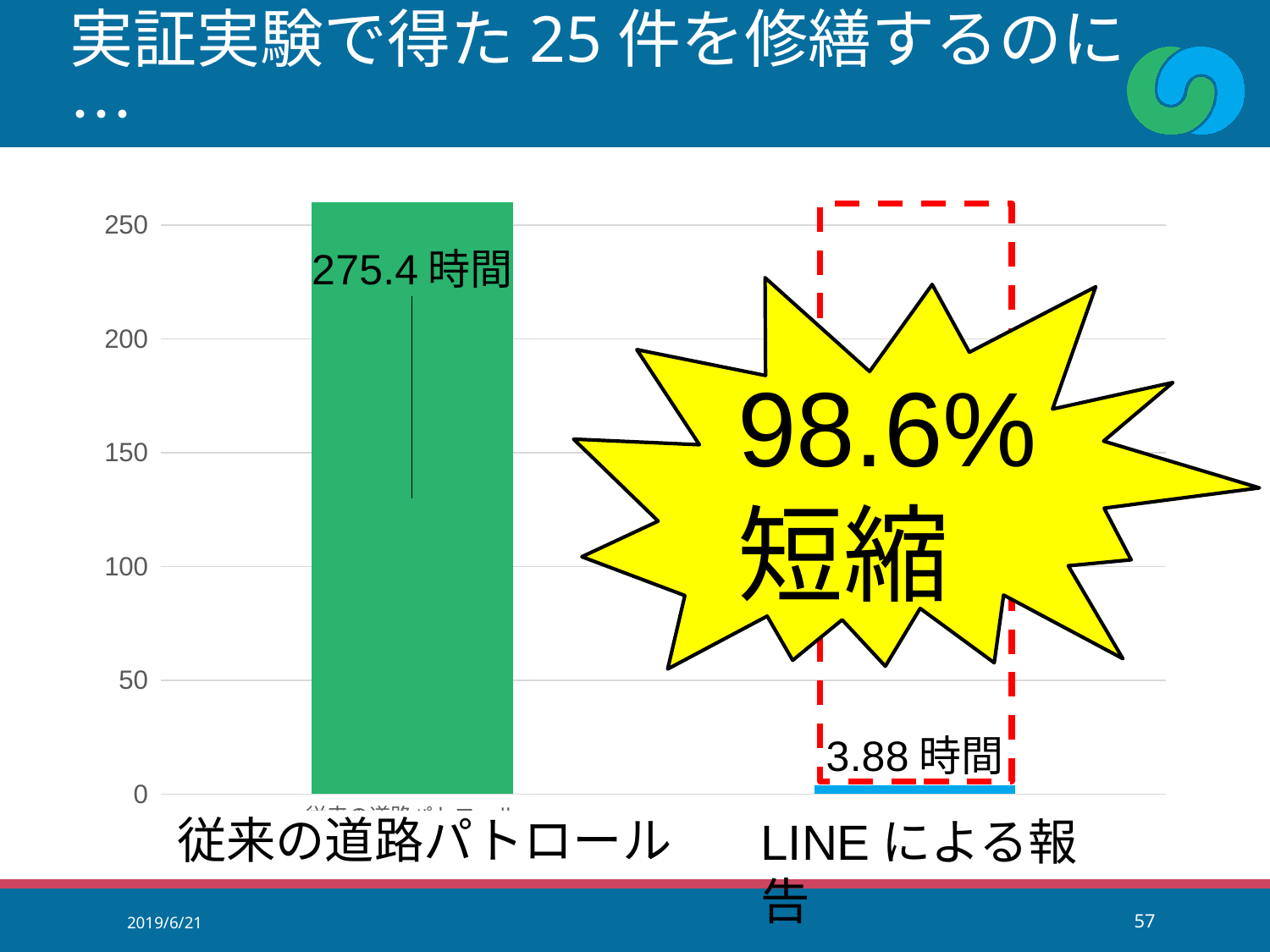
What percentage reduction is stated in the yellow starburst callout on the chart? 98.6% Is the value for LINE による報告 greater or less than 50? less Is the value for 従来の道路パトロール greater or less than 250? greater How many categories are plotted in the chart? 2 What colour is the bar for 従来の道路パトロール? green What value is shown for LINE による報告? 3.88 時間 What kind of chart is shown on the slide? bar chart Which is larger, the value for 従来の道路パトロール or the value for LINE による報告? 従来の道路パトロール What is the difference between the value for 従来の道路パトロール and the value for LINE による報告? 271.52 時間 Which category has the lowest value? LINE による報告 Which category has the highest value? 従来の道路パトロール What value is shown for 従来の道路パトロール? 275.4 時間